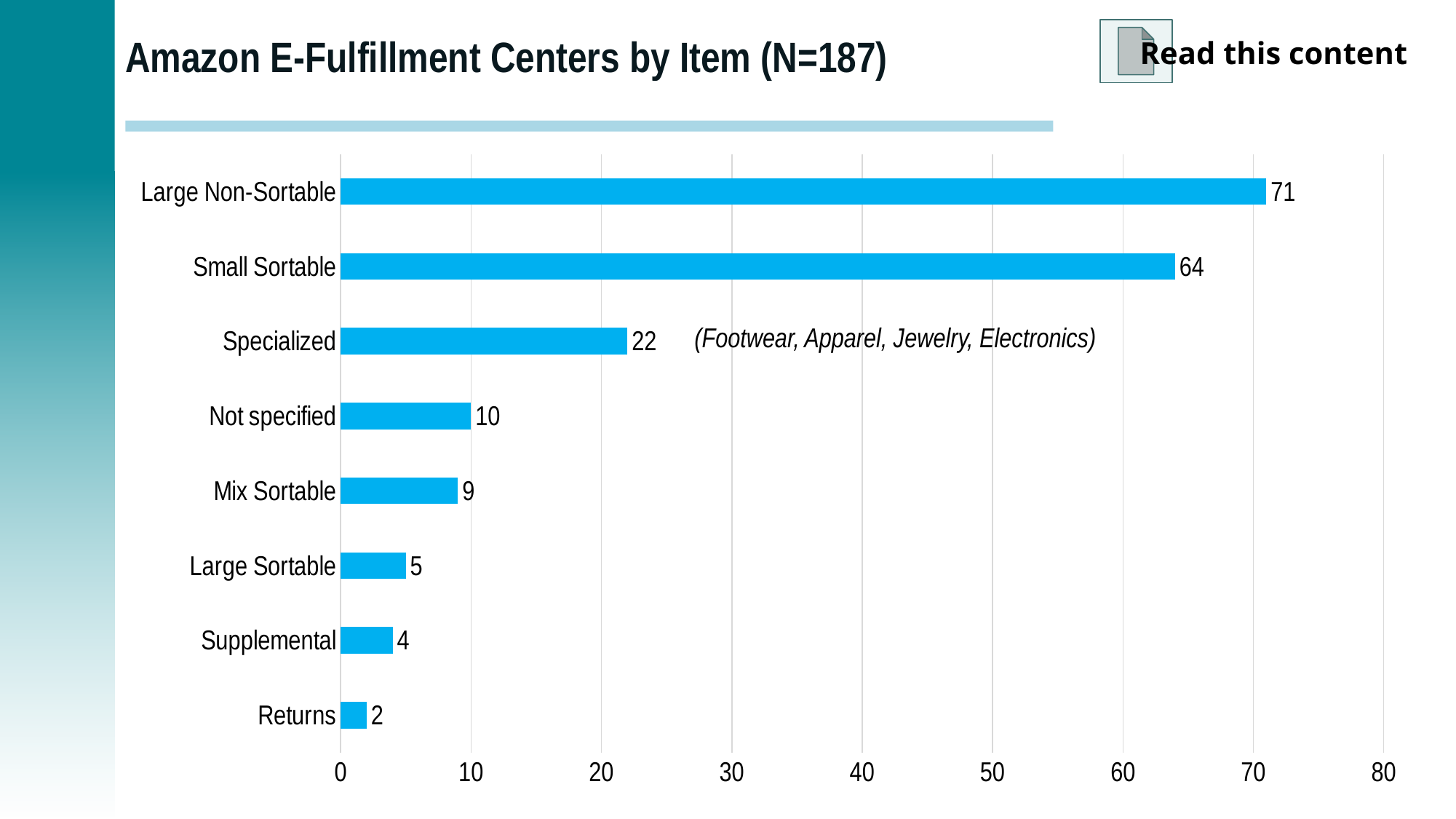
Is the value for Small Sortable greater or less than 60? greater What is the difference between the values for Specialized and Not specified? 12 Which category has the lowest value? Returns What is the title of the chart? Amazon E-Fulfillment Centers by Item (N=187) What is the value for Specialized? 22 What is the value for Large Non-Sortable? 71 What is the value for Supplemental? 4 Which is larger, the value for Mix Sortable or the value for Large Sortable? Mix Sortable What is the difference between the values for Large Non-Sortable and Small Sortable? 7 Which category has the highest value? Large Non-Sortable How many categories are shown in the chart? 8 What kind of chart is shown on the slide? bar chart